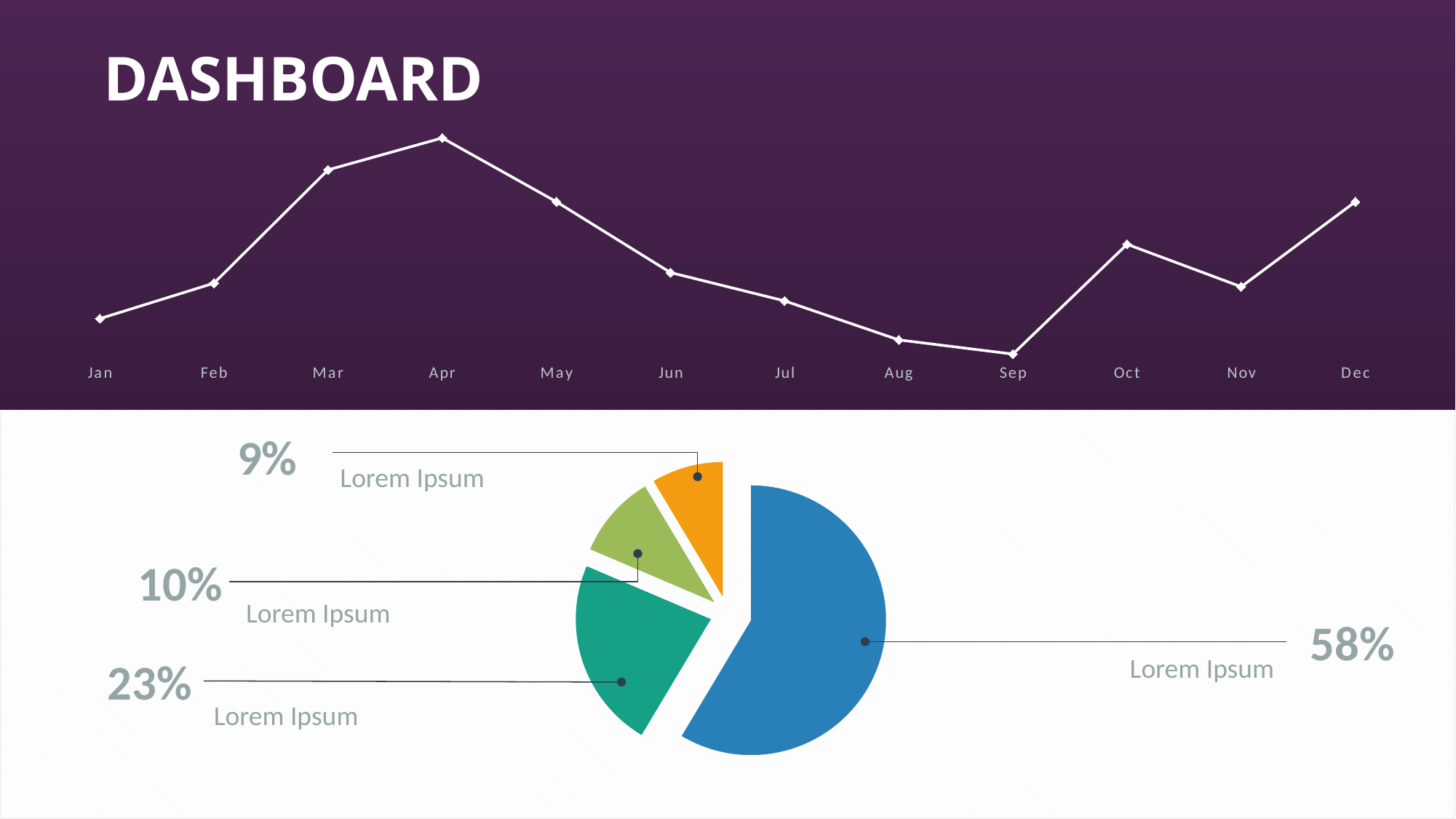
In the pie chart at the bottom of the slide, what share does the large blue slice represent? 58% What kind of chart is shown at the top of the slide? line chart In the line chart at the top of the slide, which month has the highest value? Apr How many slices does the pie chart at the bottom of the slide have? 4 What kind of chart is shown at the bottom of the slide? pie chart In the line chart at the top of the slide, do the values rise or fall from Apr to Sep? fall In the line chart at the top of the slide, is the value for Dec higher or lower than the value for Nov? higher In the pie chart at the bottom of the slide, what is the difference between the blue slice (58%) and the teal slice (23%)? 35% In the line chart at the top of the slide, is the value for Mar higher or lower than the value for Feb? higher In the pie chart at the bottom of the slide, what share does the orange slice represent? 9% How many months are plotted on the x axis of the line chart at the top of the slide? 12 In the line chart at the top of the slide, which month has the lowest value? Sep